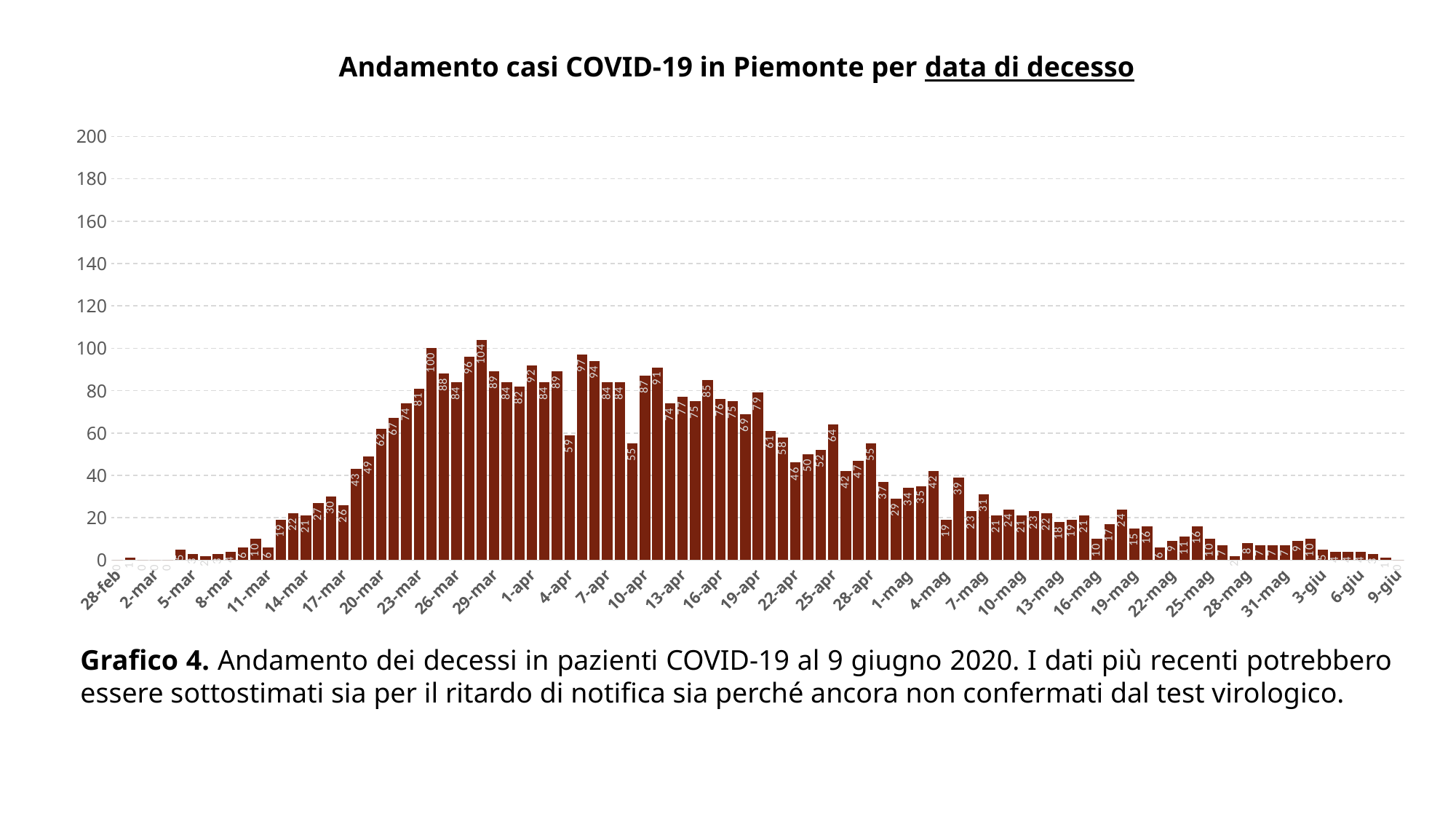
What is the value shown for 1-apr? 92 Is the value for 20-mar greater or less than 60? greater What is the value shown for 7-mag? 31 What is the value shown for 29-mar? 89 Which date has the larger value, 26-mar or 22-apr? 26-mar What is the difference between the values for 29-mar and 1-apr? 3 What is the highest value shown on the vertical axis? 200 What is the title of the chart? Andamento casi COVID-19 in Piemonte per data di decesso What is the value shown for 10-apr? 87 Do the values generally rise or fall from 29-mar to 9-giu? fall What kind of chart is shown on the slide? bar chart